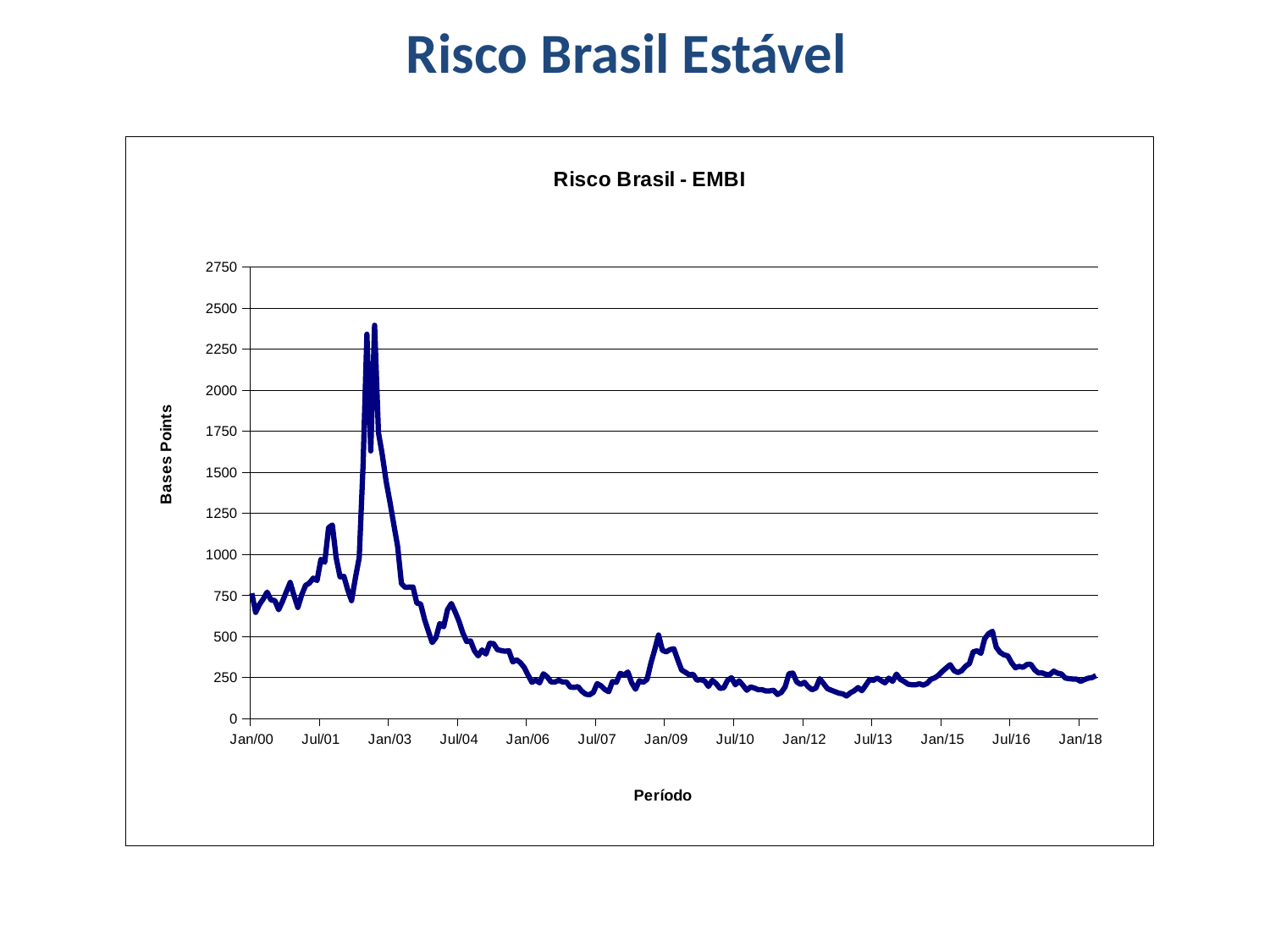
What is the label of the vertical axis? Bases Points Is the value at Jan/18 greater or less than 500? less Is the value at Jan/00 greater or less than 500? greater Is the value at Jan/03 higher or lower than the value at Jan/15? higher Is the highest point of the line greater or less than 2000? greater How many tick labels are shown on the x axis? 13 What is the title of the chart? Risco Brasil - EMBI Which x-axis tick label is closest to the highest point of the line? Jan/03 How many lines are plotted on the chart? 1 What kind of chart is shown on the slide? Line chart Between Jan/03 and Jan/06, does the line generally rise or fall? fall